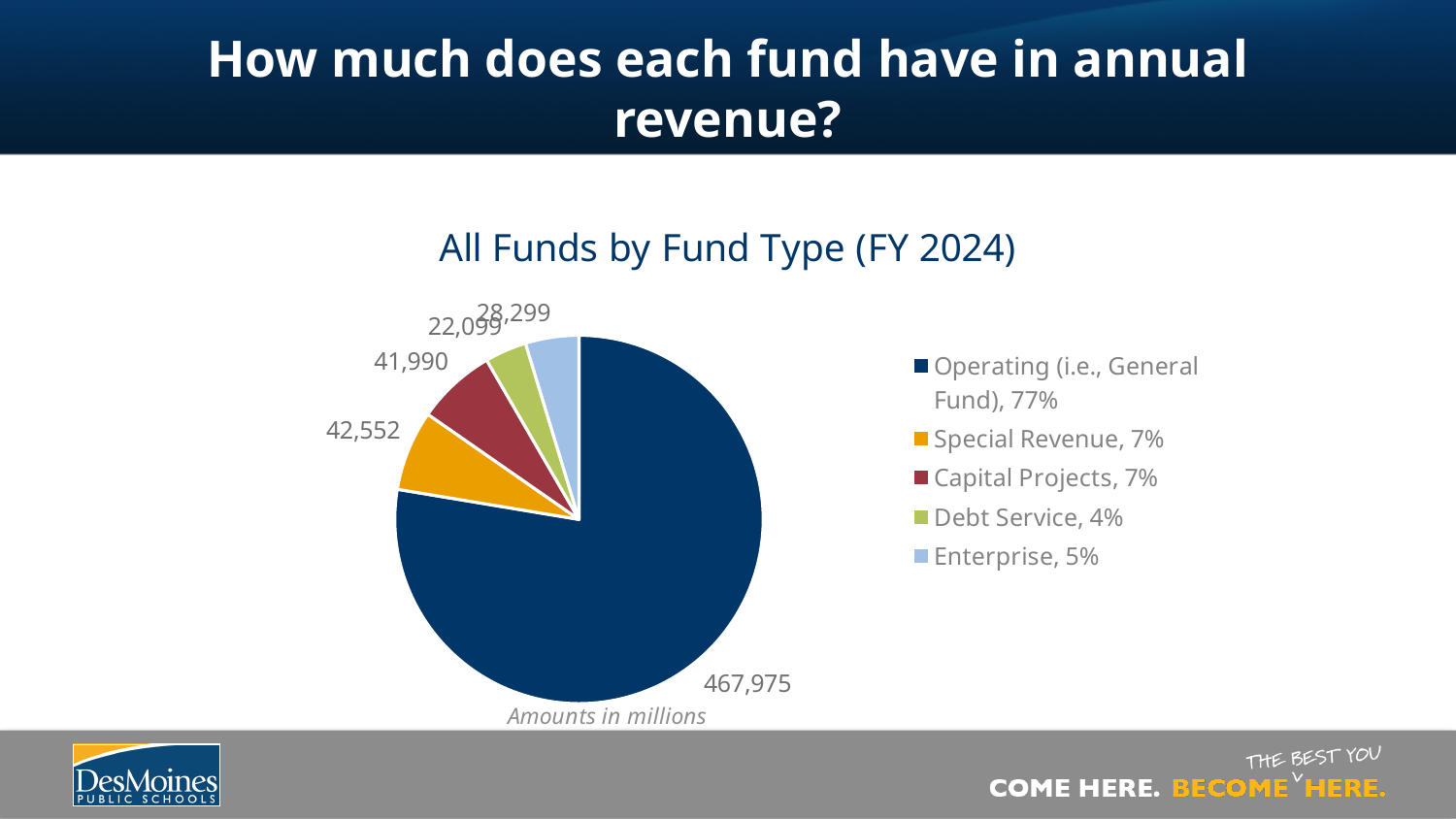
What is the title of the chart? All Funds by Fund Type (FY 2024) Which fund type has the largest slice of the pie? Operating (i.e., General Fund) How many fund types are shown in the pie chart? 5 What share of the pie does the Operating (i.e., General Fund) slice represent? 77% What is the difference between the Special Revenue value and the Capital Projects value? 562 Which is larger, the Enterprise slice or the Debt Service slice? Enterprise Which fund type has the smallest slice of the pie? Debt Service What share of the pie does Debt Service represent? 4% What is the value shown for the Operating (i.e., General Fund) slice? 467,975 What kind of chart is shown on the slide? Pie chart What is the value shown for the Special Revenue slice? 42,552 What is the value shown for the Capital Projects slice? 41,990